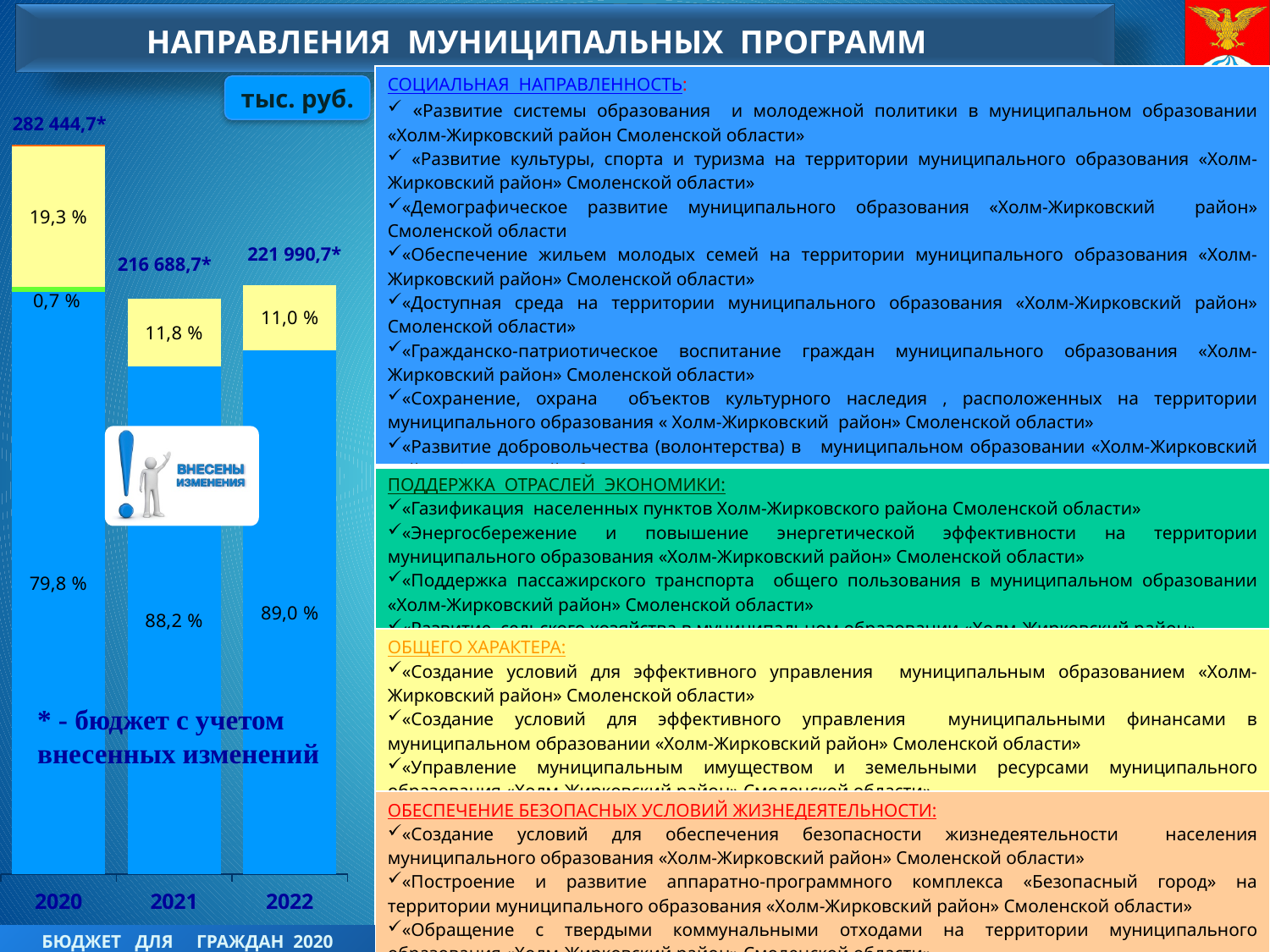
What percentage is shown for the green segment of the 2020 bar? 0,7 % How many years (bars) are shown on the chart? 3 What is the total value shown above the bar for 2022? 221 990,7* Which year has the highest total value? 2020 What percentage is shown for the blue (bottom) segment of the 2021 bar? 88,2 % What type of chart is shown on the slide? stacked bar chart What is the total value shown above the bar for 2021? 216 688,7* What unit of measurement is indicated for the chart? тыс. руб. What is the total value shown above the bar for 2020? 282 444,7* Is the total for 2022 larger or smaller than the total for 2021? larger What percentage is shown for the yellow (top) segment of the 2022 bar? 11,0 % Which year has the lowest total value? 2021